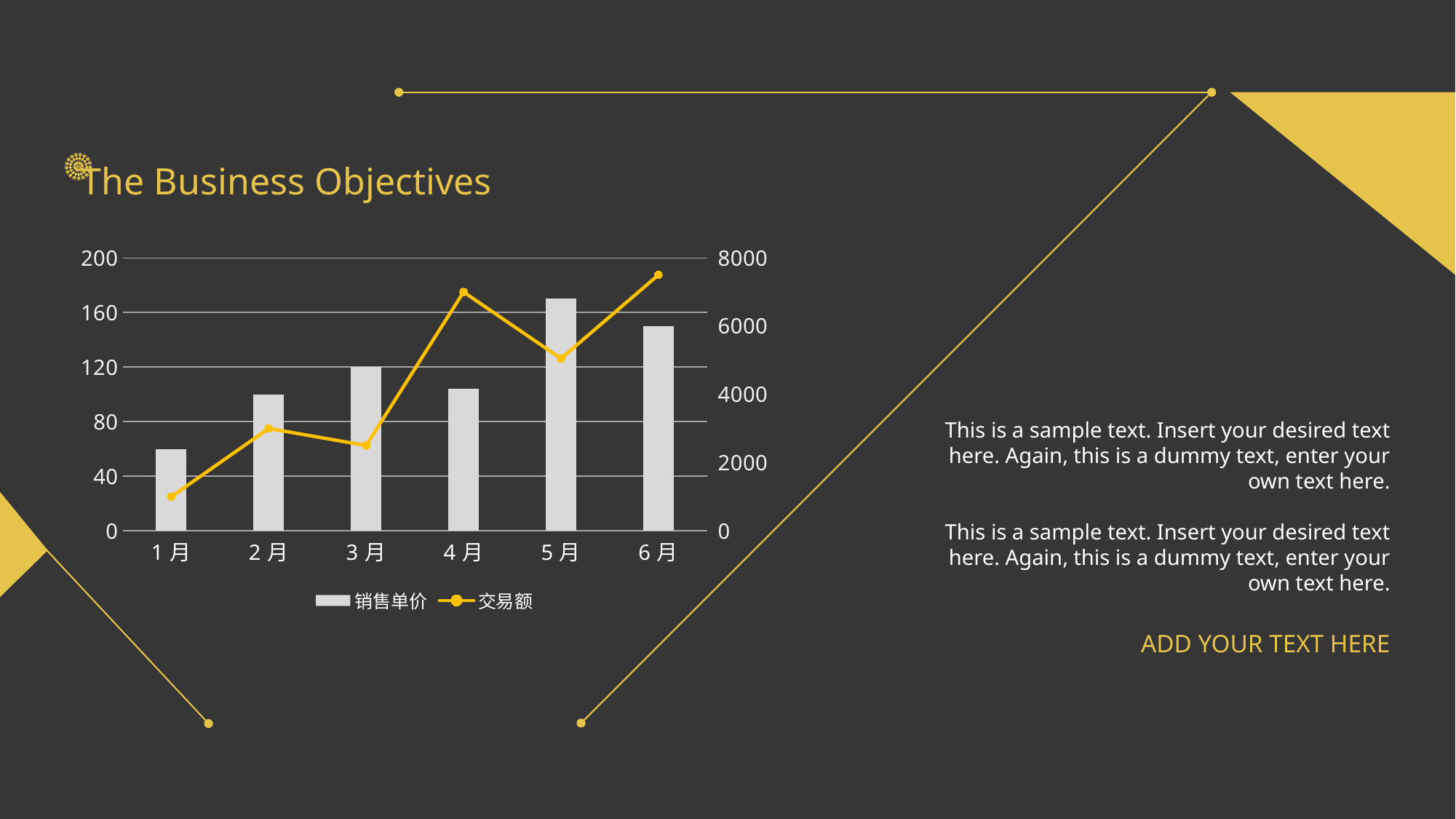
Which series is drawn as a line in the chart? 交易额 Which month has the shortest 销售单价 bar? 1 月 Is the 销售单价 value for 1 月 greater or less than 80? less Is the 交易额 value for 1 月 greater or less than 2000? less How many months are shown on the x axis of the chart? 6 What is the 销售单价 value for 3 月? 120 Which month has the tallest 销售单价 bar? 5 月 What kind of chart is shown on the slide? A combined bar and line chart Is the 交易额 value for 4 月 greater or less than 6000? greater Which month has the higher 交易额 value, 4 月 or 5 月? 4 月 How many series does the chart legend list? 2